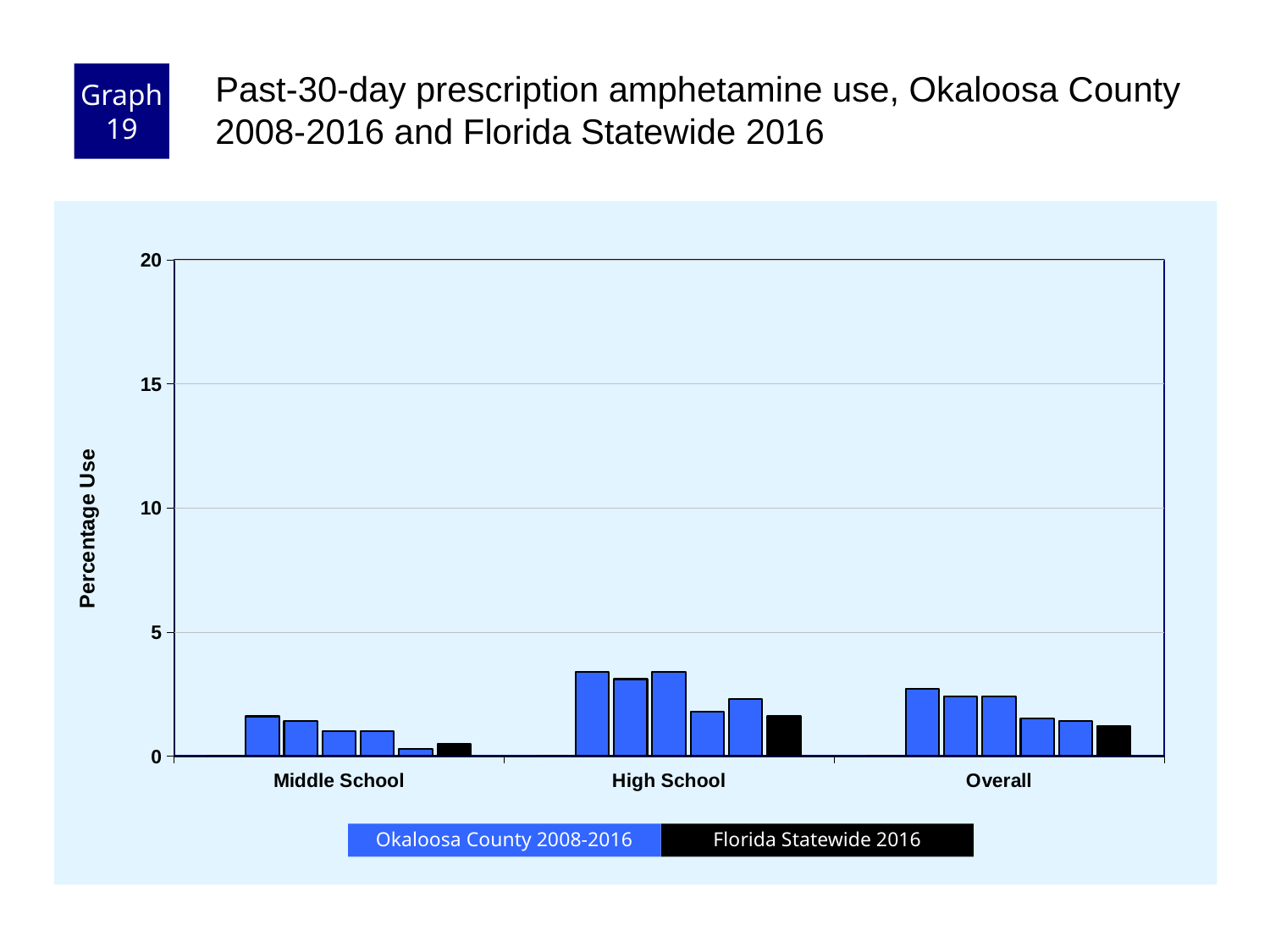
Is the Florida Statewide 2016 value for Middle School greater or less than 5? less What kind of chart is shown on the slide? bar chart Which is larger, the Florida Statewide 2016 value for Overall or for Middle School? Overall Is the tallest Okaloosa County bar for High School greater or less than 5? less How many categories are shown on the x axis? 3 What is the label on the y axis? Percentage Use Which category has the tallest bar? High School Is the Florida Statewide 2016 value for High School greater or less than 5? less Which category has the shortest bar? Middle School Which colour represents Florida Statewide 2016 in the legend? black How many series does the legend list? 2 Which is larger, the Florida Statewide 2016 value for High School or for Middle School? High School